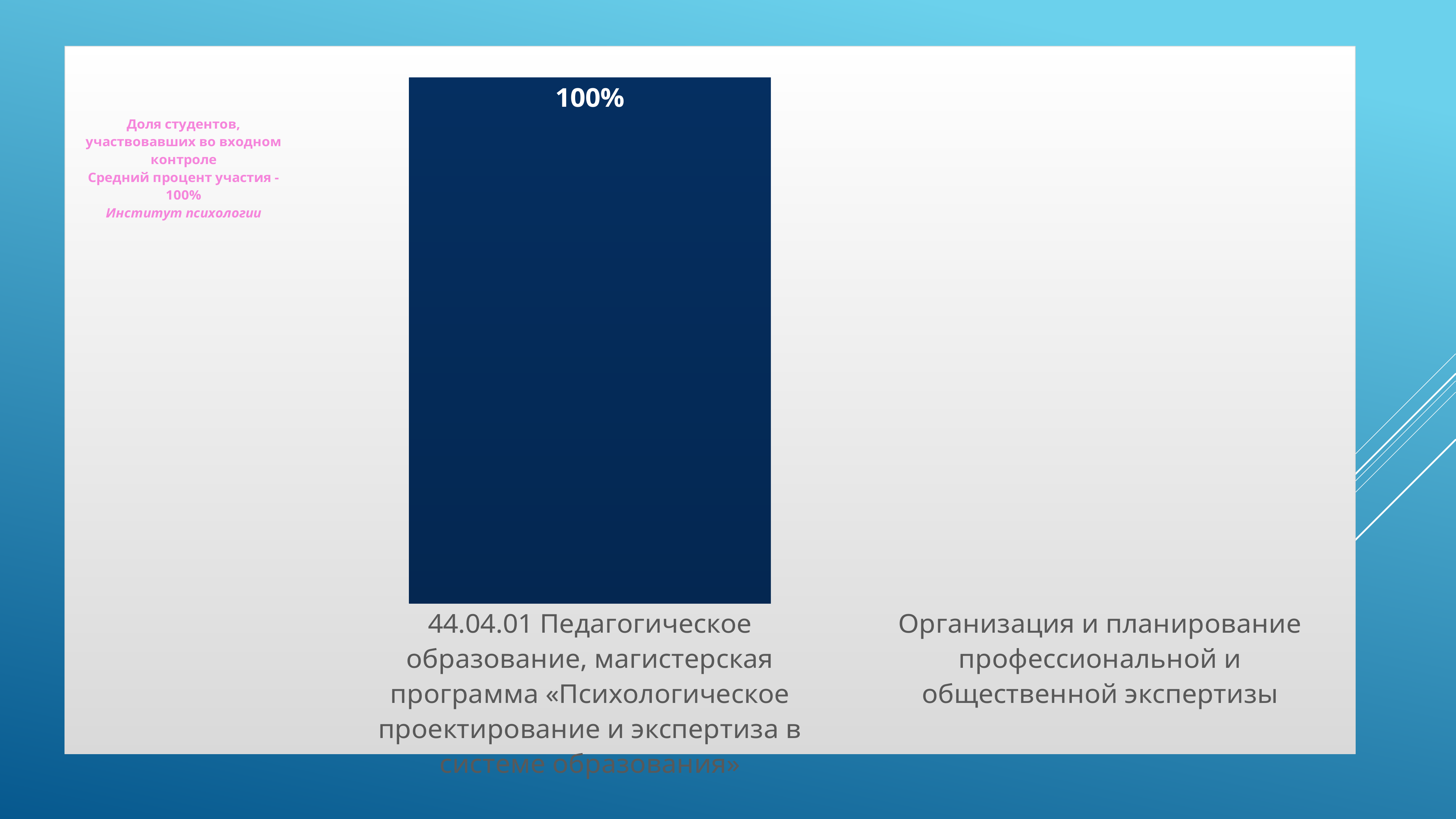
Which category has the highest value in the chart? 44.04.01 Педагогическое образование, магистерская программа «Психологическое проектирование и экспертиза в системе образования» What kind of chart is shown on the slide? Bar chart What is the value shown for 44.04.01 Педагогическое образование, магистерская программа «Психологическое проектирование и экспертиза в системе образования»? 100% How many categories are labelled on the x axis of the chart? 2 What institute is named in the chart's title text? Институт психологии What colour is the bar in the chart? Dark blue